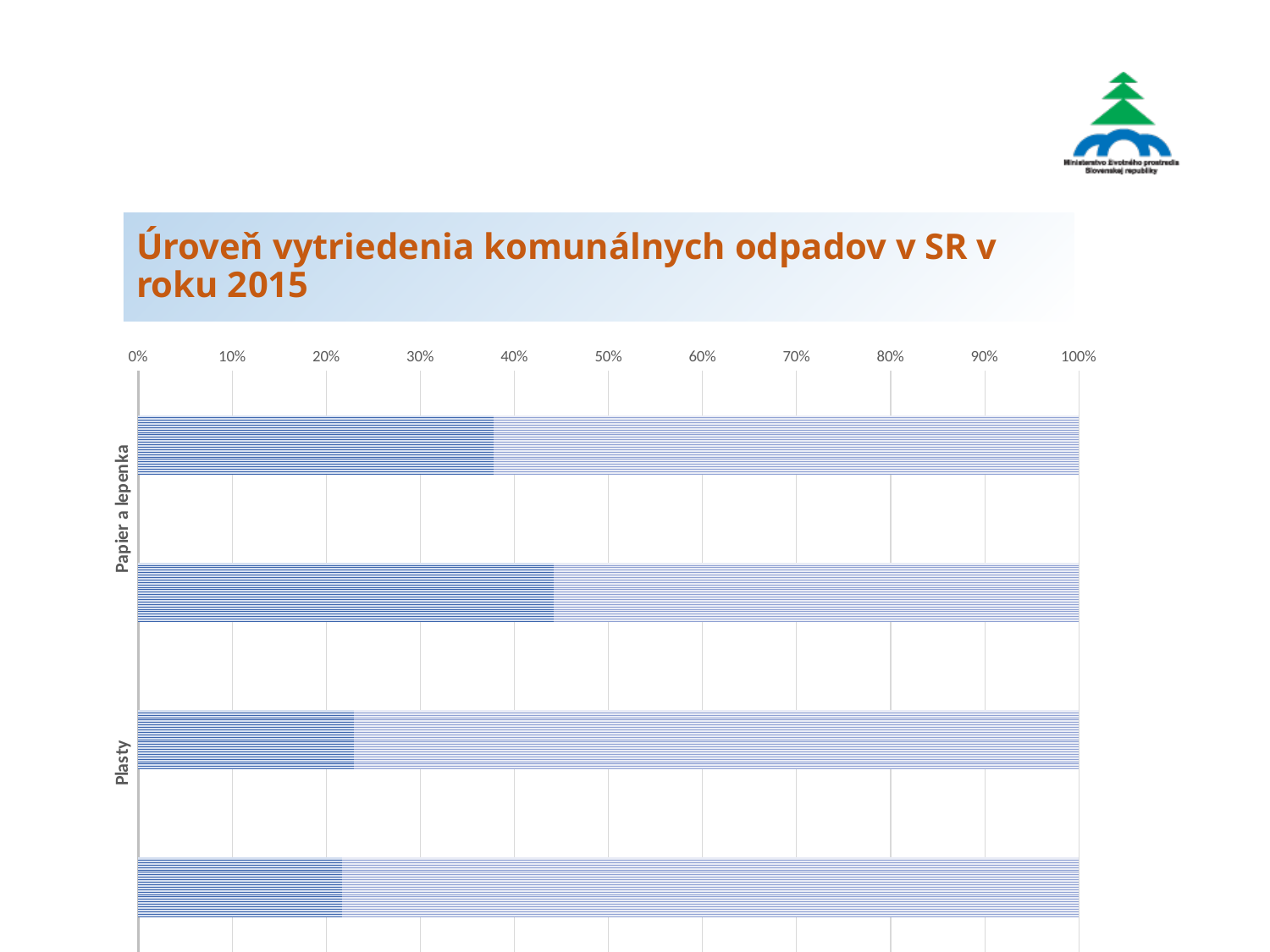
Is the value of the second bar from the top greater or less than 50%? less Is the value of the third bar from the top greater or less than 30%? less What kind of chart is shown on the slide? bar chart Is the value of the second bar from the top greater or less than 40%? greater Which is larger, the topmost bar or the third bar from the top? the topmost bar Which two category labels are printed on the vertical axis of the chart? Papier a lepenka and Plasty What is the title of the chart on the slide? Úroveň vytriedenia komunálnych odpadov v SR v roku 2015 Which bar is the longest in the chart? the second bar from the top How many bars are plotted in the chart? 4